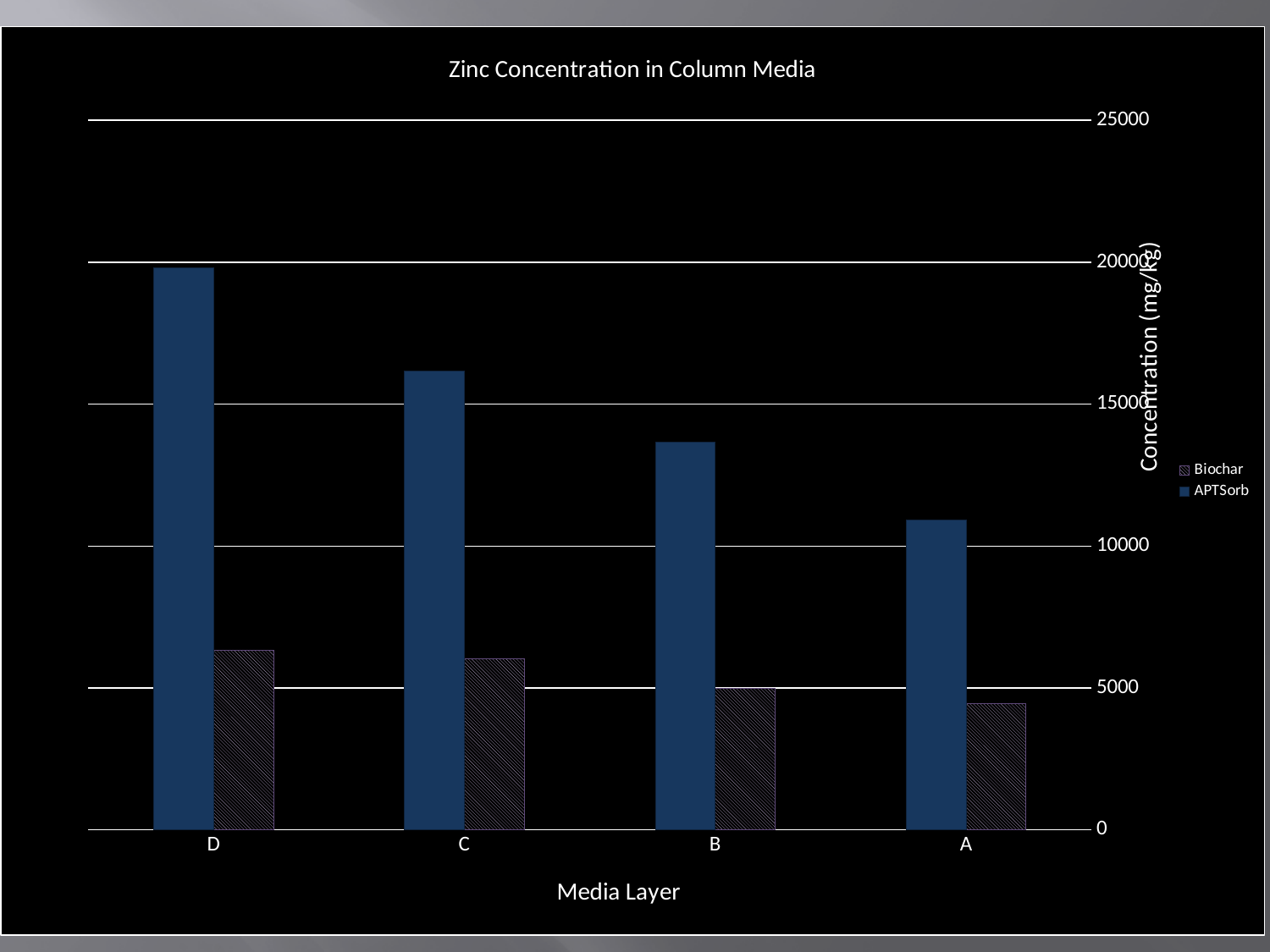
Is the APTSorb value for layer C greater or less than 15000? greater What kind of chart is shown on the slide? bar chart What is the title of the chart? Zinc Concentration in Column Media Which media layer has the lowest APTSorb zinc concentration? A How many series does the legend list? 2 Which media layer has the lowest Biochar zinc concentration? A Which media layer has the highest APTSorb zinc concentration? D Do the APTSorb values rise or fall moving from D to A along the x axis? fall How many media layers are shown on the x axis? 4 Is the Biochar value for layer A greater or less than 5000? less Is the APTSorb value for layer B greater or less than 15000? less For layer D, which series has the larger value, Biochar or APTSorb? APTSorb